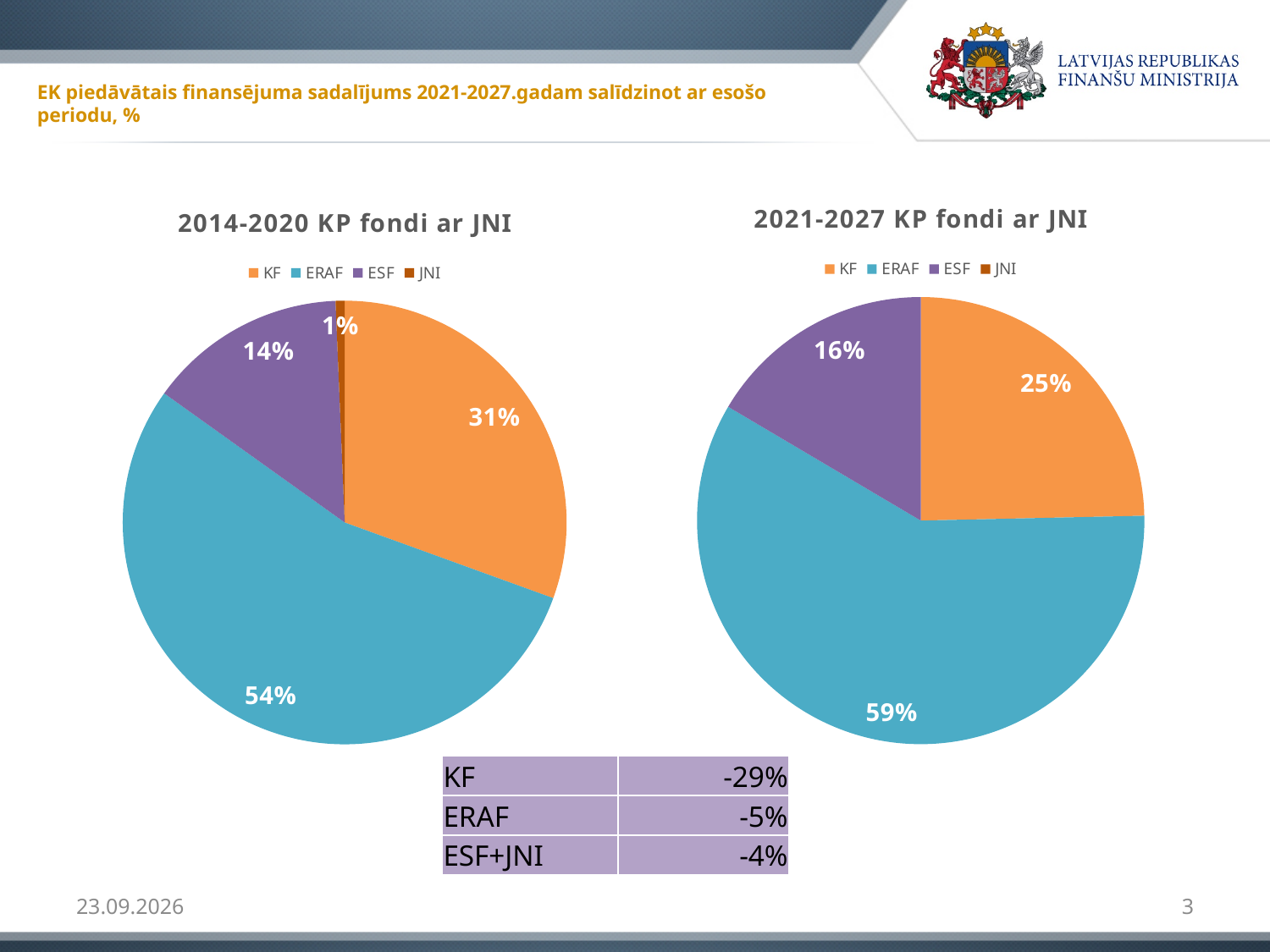
In the '2014-2020 KP fondi ar JNI' chart, which fund has the smallest slice? JNI In the '2014-2020 KP fondi ar JNI' chart, what is the difference between the ERAF share and the KF share? 23% What type of chart is the '2014-2020 KP fondi ar JNI' chart? Pie chart In the '2014-2020 KP fondi ar JNI' chart, what share does KF have? 31% In the '2021-2027 KP fondi ar JNI' chart, what share does KF have? 25% In the '2021-2027 KP fondi ar JNI' chart, which fund has the largest slice? ERAF In the '2021-2027 KP fondi ar JNI' chart, what is the difference between the ERAF share and the ESF share? 43% How many entries does the legend of the '2021-2027 KP fondi ar JNI' chart list? 4 In the '2021-2027 KP fondi ar JNI' chart, what share does ESF have? 16% In the '2014-2020 KP fondi ar JNI' chart, what share does ERAF have? 54% In the '2014-2020 KP fondi ar JNI' chart, which fund has the largest slice? ERAF Is the KF share larger in the '2014-2020 KP fondi ar JNI' chart or in the '2021-2027 KP fondi ar JNI' chart? 2014-2020 KP fondi ar JNI